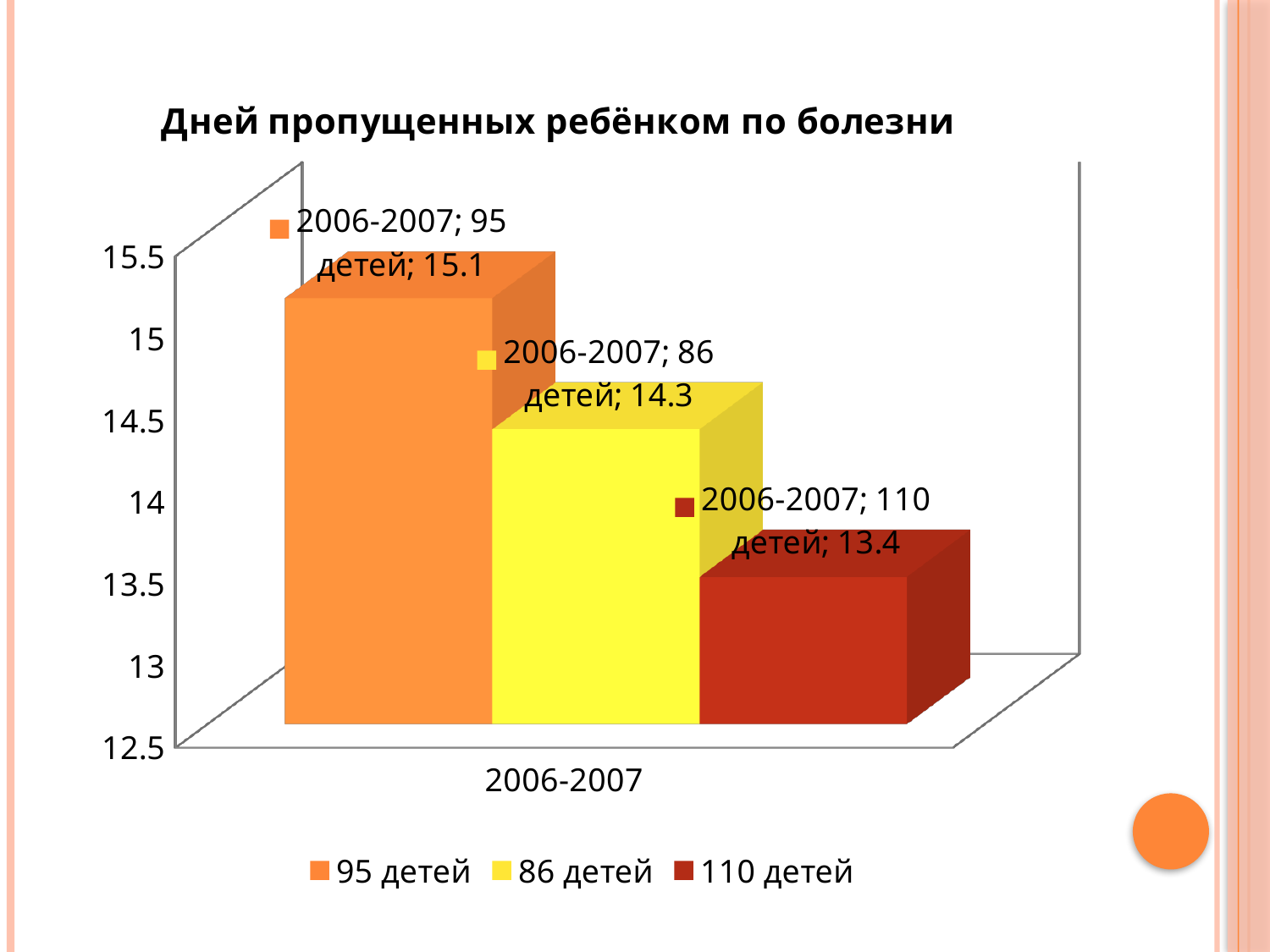
What is the difference between the values for "95 детей" and "86 детей"? 0.8 What is the difference between the values for "95 детей" and "110 детей"? 1.7 Which is larger, the value for "86 детей" or the value for "110 детей"? 86 детей What is the value for the "86 детей" series in 2006-2007? 14.3 What is the title of the chart? Дней пропущенных ребёнком по болезни How many series does the legend list? 3 Is the value for "86 детей" greater or less than 14? greater What is the value for the "110 детей" series in 2006-2007? 13.4 Which series has the highest value? 95 детей What kind of chart is shown on the slide? Bar chart Which series has the lowest value? 110 детей What is the value for the "95 детей" series in 2006-2007? 15.1